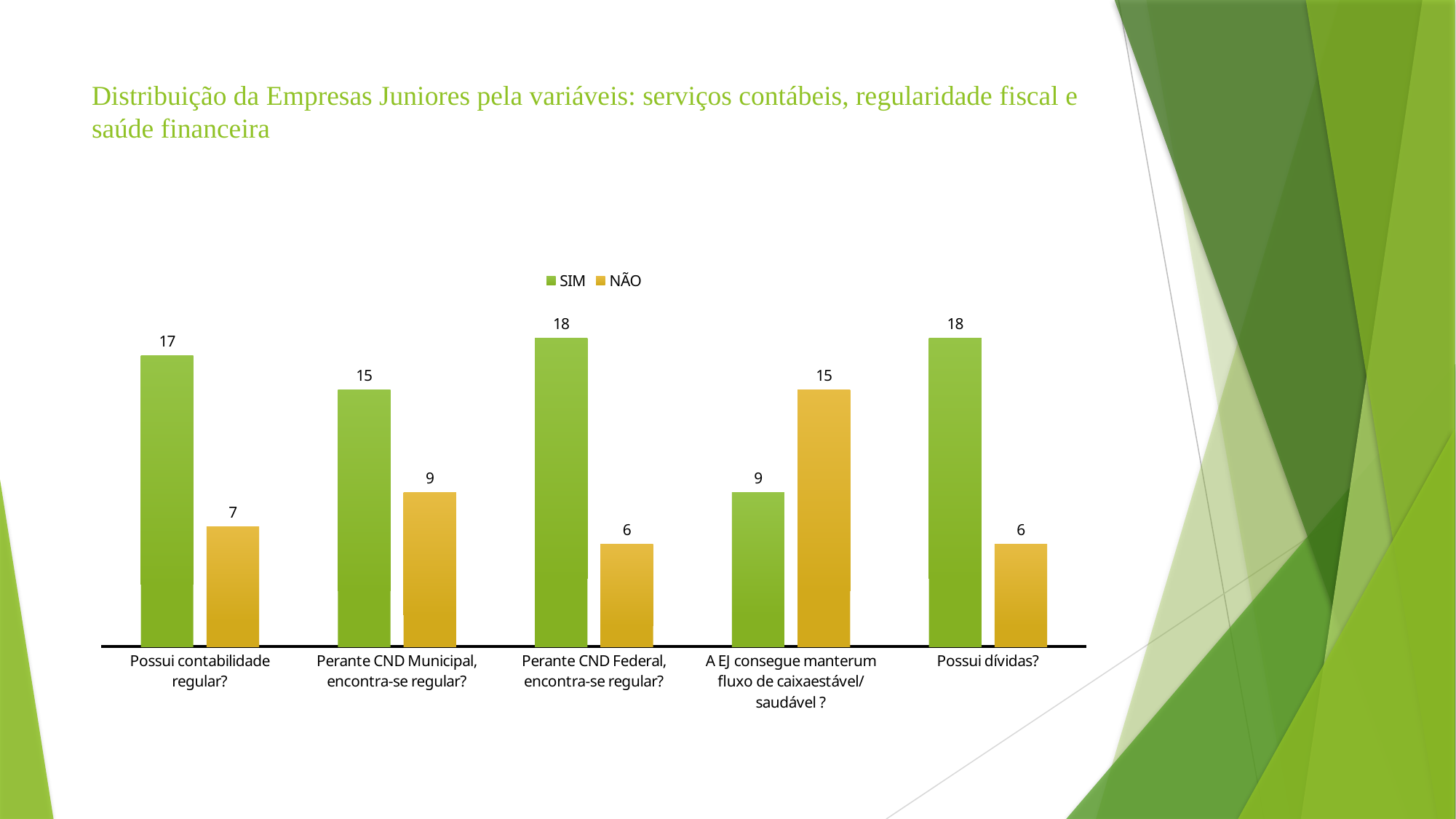
What kind of chart is shown on the slide? Bar chart What is the SIM value for "Possui contabilidade regular?"? 17 What is the difference between the SIM and NÃO values for "Perante CND Federal, encontra-se regular?"? 12 What is the SIM value for "A EJ consegue manterum fluxo de caixaestável/ saudável ?"? 9 For "A EJ consegue manterum fluxo de caixaestável/ saudável ?", which is larger, SIM or NÃO? NÃO Which category has the highest NÃO value? A EJ consegue manterum fluxo de caixaestável/ saudável ? Which category has the lowest SIM value? A EJ consegue manterum fluxo de caixaestável/ saudável ? What colour are the NÃO bars? Orange/gold What is the NÃO value for "Perante CND Municipal, encontra-se regular?"? 9 What is the NÃO value for "Possui dívidas?"? 6 How many series does the legend list? 2 How many categories are shown on the x axis? 5